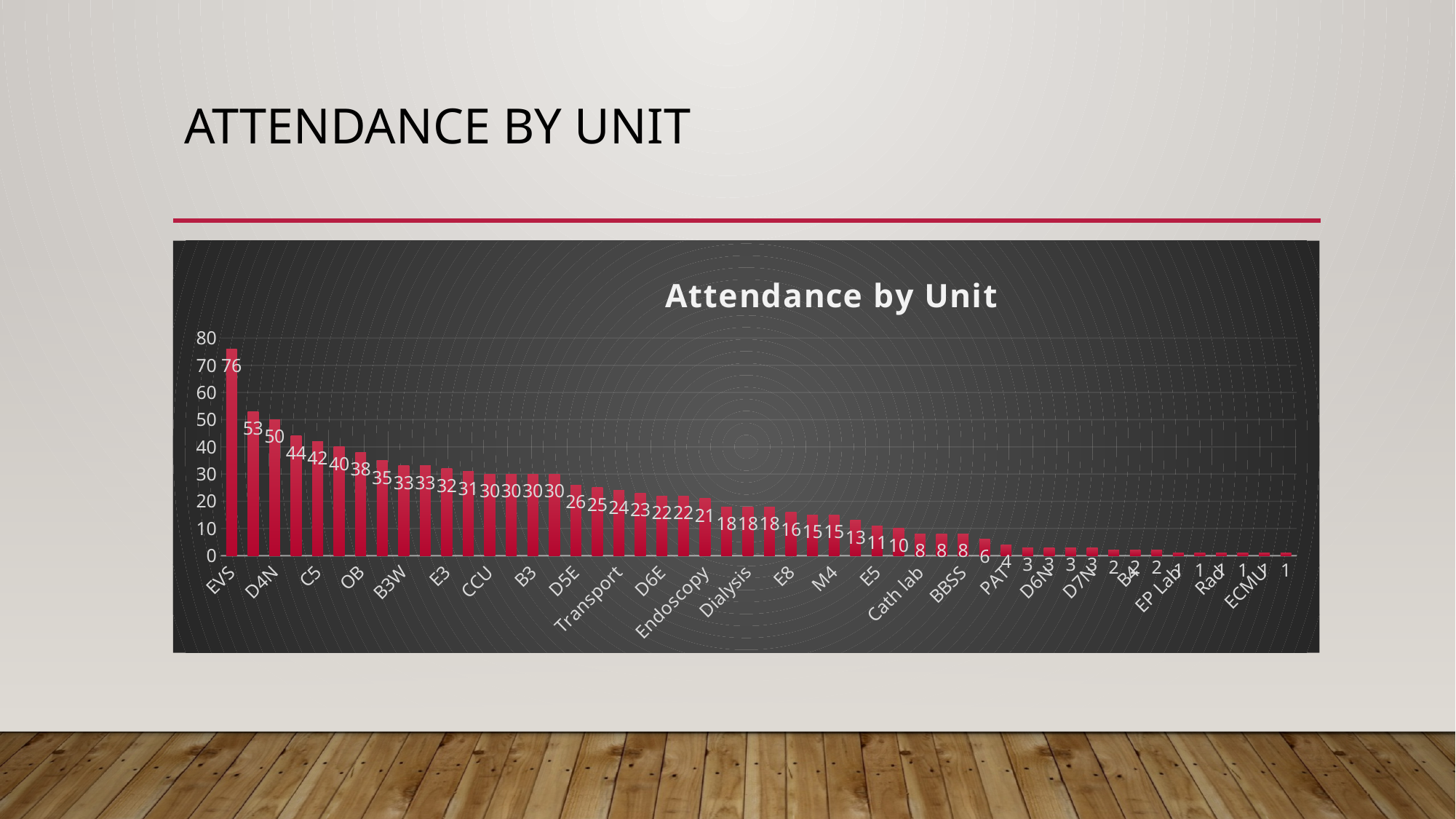
Is the value for Cath lab greater or less than 20? less What is the attendance value for EVS? 76 What is the title of the chart? Attendance by Unit Is the value for EVS greater or less than 70? greater Do the attendance values rise or fall moving from left to right along the x axis? fall What is the highest attendance value shown on the chart? 76 Which has the larger attendance, EVS or D4N? EVS Which unit has the highest attendance? EVS Which has the larger attendance, C5 or M4? C5 Is the value for ECMU greater or less than 10? less What kind of chart is shown on the slide? bar chart What is the lowest attendance value shown on the chart? 1